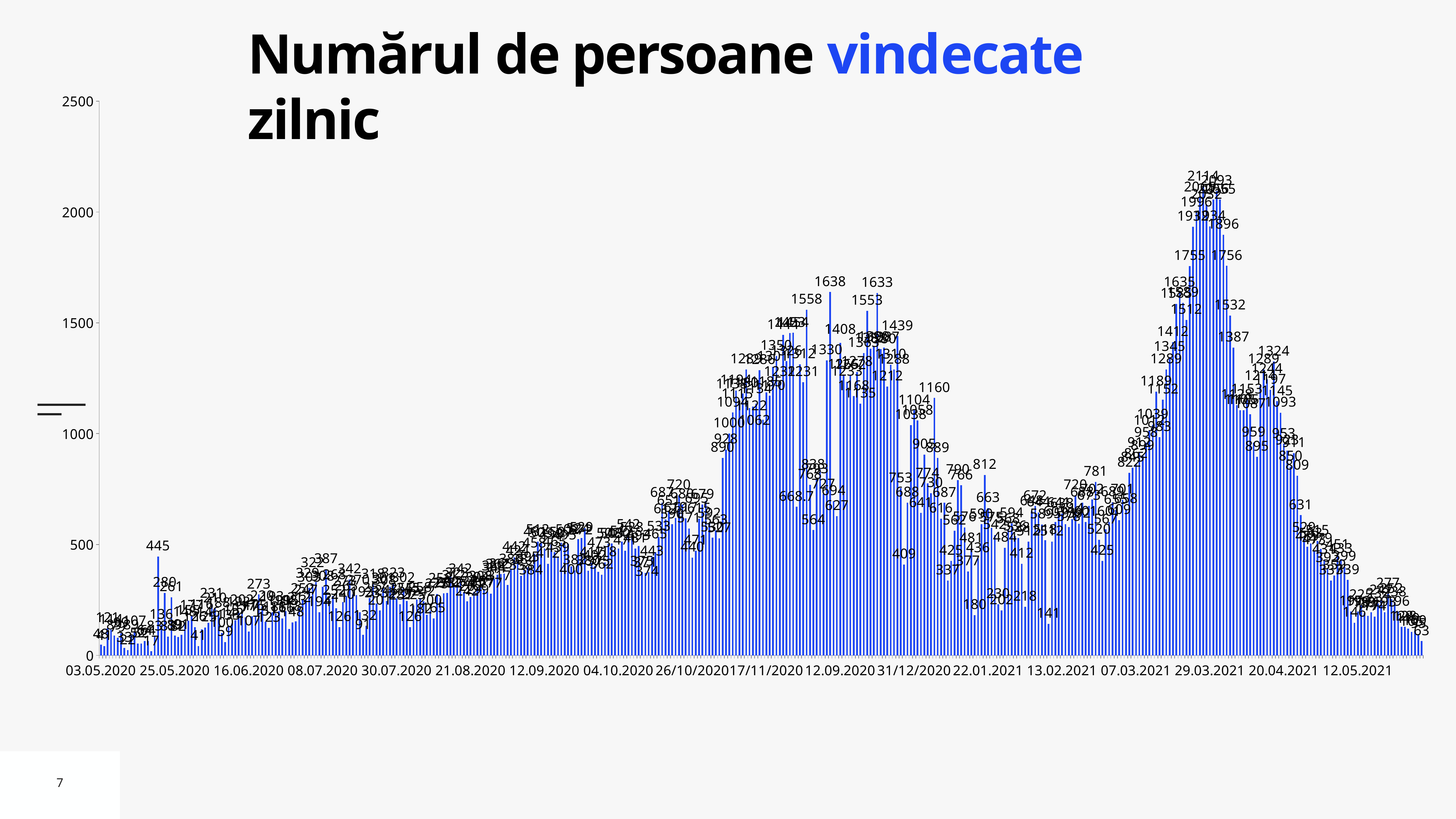
Which is larger, the peak labelled 2114 or the peak labelled 1638? 2114 What is the highest daily value labelled on the chart? 2114 What is the value of the last bar on the right of the chart? 63 What is the highest value shown on the vertical axis? 2500 What is the title of the chart? Numărul de persoane vindecate zilnic What kind of chart is shown on the slide? bar chart What is the difference between the bars labelled 1638 and 1633? 5 Do the values generally rise or fall between 29.03.2021 and 12.05.2021? fall What is the difference between the peak labelled 2114 and the peak labelled 1638? 476 Is the spike labelled 445 near 25.05.2020 greater or less than 500? less Is the highest bar, near 29.03.2021, greater or less than 2000? greater Is the bar labelled 141, between 22.01.2021 and 13.02.2021, greater or less than 500? less